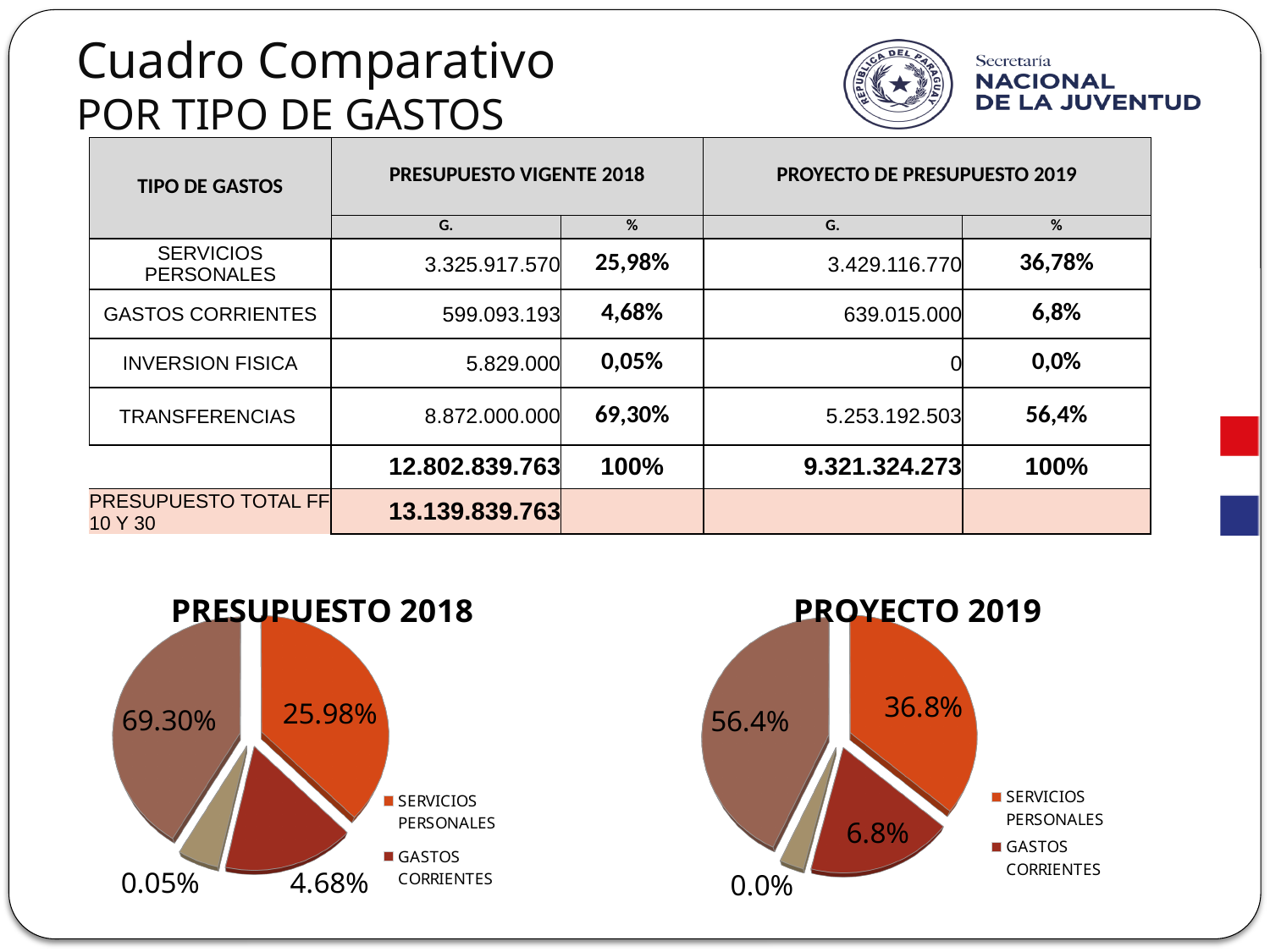
In the PROYECTO 2019 pie chart, what percentage is shown for SERVICIOS PERSONALES? 36.8% Which chart shows a larger share for SERVICIOS PERSONALES, PRESUPUESTO 2018 or PROYECTO 2019? PROYECTO 2019 How many slices does the PRESUPUESTO 2018 pie chart have? 4 In the PRESUPUESTO 2018 pie chart, what is the value of the smallest slice? 0.05% In the PRESUPUESTO 2018 pie chart, what percentage is shown for GASTOS CORRIENTES? 4.68% In the PROYECTO 2019 pie chart, what percentage is shown for GASTOS CORRIENTES? 6.8% In the PROYECTO 2019 pie chart, how much larger is the SERVICIOS PERSONALES share than the GASTOS CORRIENTES share? 30.0% In the PRESUPUESTO 2018 pie chart, what is the value of the largest slice? 69.30% In the PROYECTO 2019 pie chart, what is the value of the smallest slice? 0.0% What type of chart is used for PROYECTO 2019? Pie chart In the PRESUPUESTO 2018 pie chart, what percentage is shown for SERVICIOS PERSONALES? 25.98% In the PRESUPUESTO 2018 pie chart, how much larger is the SERVICIOS PERSONALES share than the GASTOS CORRIENTES share? 21.30%